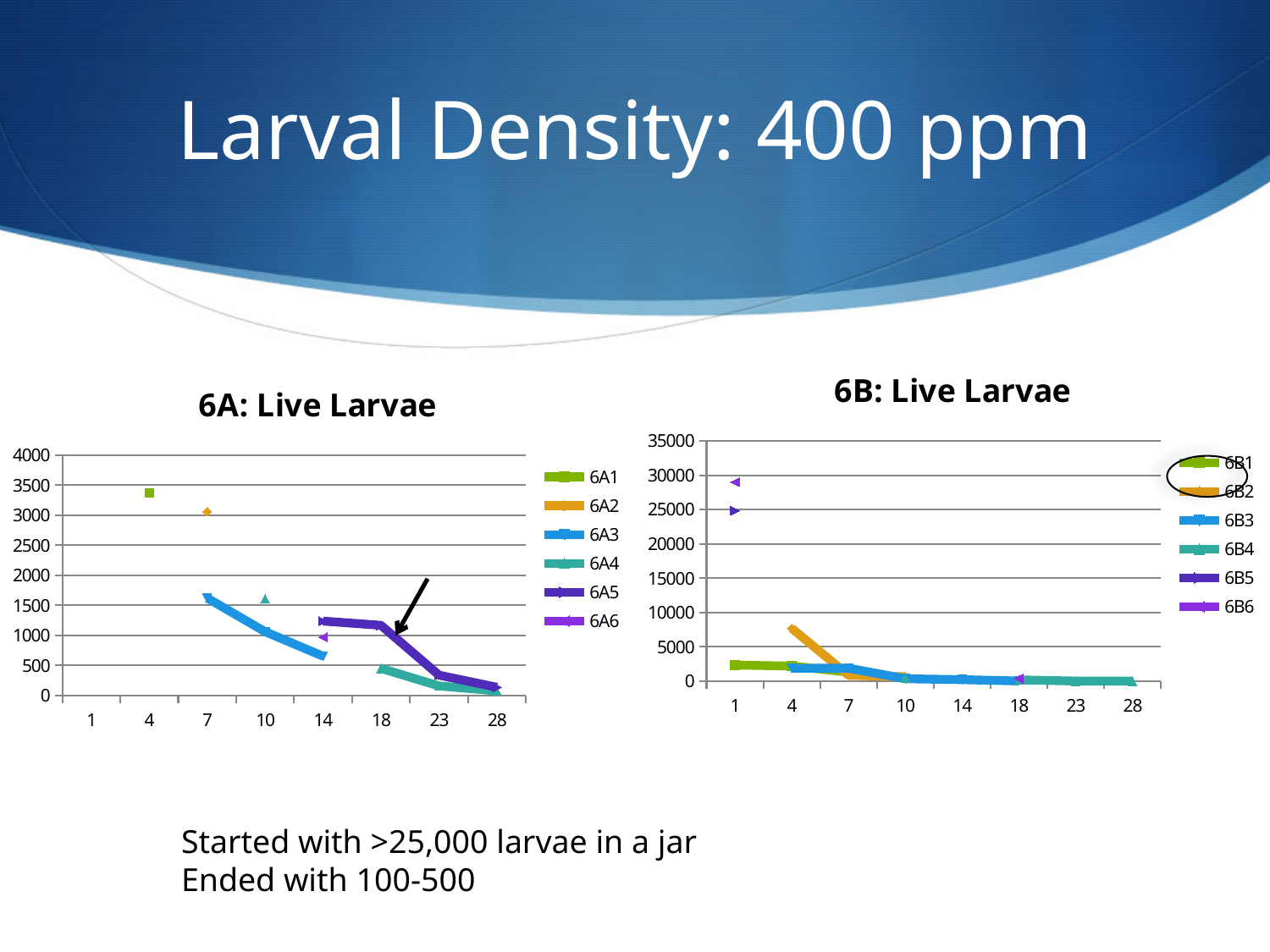
What is the title of the chart on the right side of the slide? 6B: Live Larvae In the 6A: Live Larvae chart, does the 6A3 series rise or fall from x = 7 to x = 14? fall In the 6A: Live Larvae chart, is the value for 6A5 at x = 14 greater or less than 1000? greater How many series does the legend of the 6B: Live Larvae chart list? 6 How many x-axis categories are shown on the 6A: Live Larvae chart? 8 What kind of chart is the 6A: Live Larvae chart? line chart In the 6A: Live Larvae chart, is the value for 6A1 at x = 4 greater or less than 3000? greater In the 6B: Live Larvae chart, is the value for 6B6 at x = 1 greater or less than 25000? greater